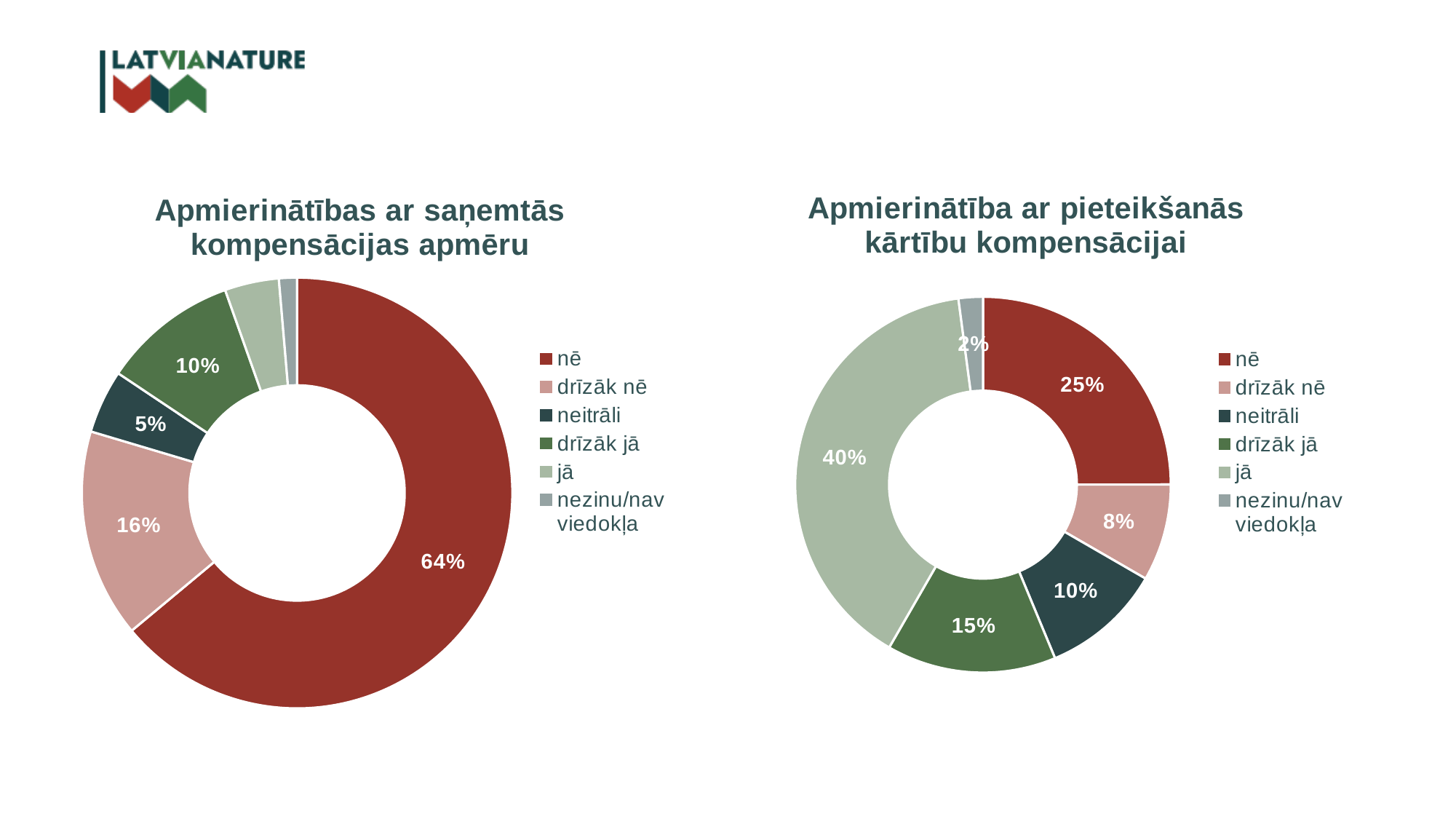
In the right chart 'Apmierinātība ar pieteikšanās kārtību kompensācijai', what share is labelled for 'nezinu/nav viedokļa'? 2% In the left chart 'Apmierinātības ar saņemtās kompensācijas apmēru', what share is labelled for 'drīzāk nē'? 16% In the right chart 'Apmierinātība ar pieteikšanās kārtību kompensācijai', what share is labelled for 'jā'? 40% In the left chart 'Apmierinātības ar saņemtās kompensācijas apmēru', which category has the largest slice? nē In the left chart 'Apmierinātības ar saņemtās kompensācijas apmēru', what share is labelled for 'neitrāli'? 5% In the right chart 'Apmierinātība ar pieteikšanās kārtību kompensācijai', what is the difference between the 'jā' share and the 'nē' share? 15% What kind of chart is the left chart 'Apmierinātības ar saņemtās kompensācijas apmēru'? Pie (doughnut) chart In the right chart 'Apmierinātība ar pieteikšanās kārtību kompensācijai', which category has the smallest slice? nezinu/nav viedokļa In the right chart 'Apmierinātība ar pieteikšanās kārtību kompensācijai', what share is labelled for 'nē'? 25% How many categories does the legend of the right chart 'Apmierinātība ar pieteikšanās kārtību kompensācijai' list? 6 In the left chart 'Apmierinātības ar saņemtās kompensācijas apmēru', what share is labelled for 'nē'? 64% In the left chart 'Apmierinātības ar saņemtās kompensācijas apmēru', which is larger: 'drīzāk nē' or 'drīzāk jā'? drīzāk nē